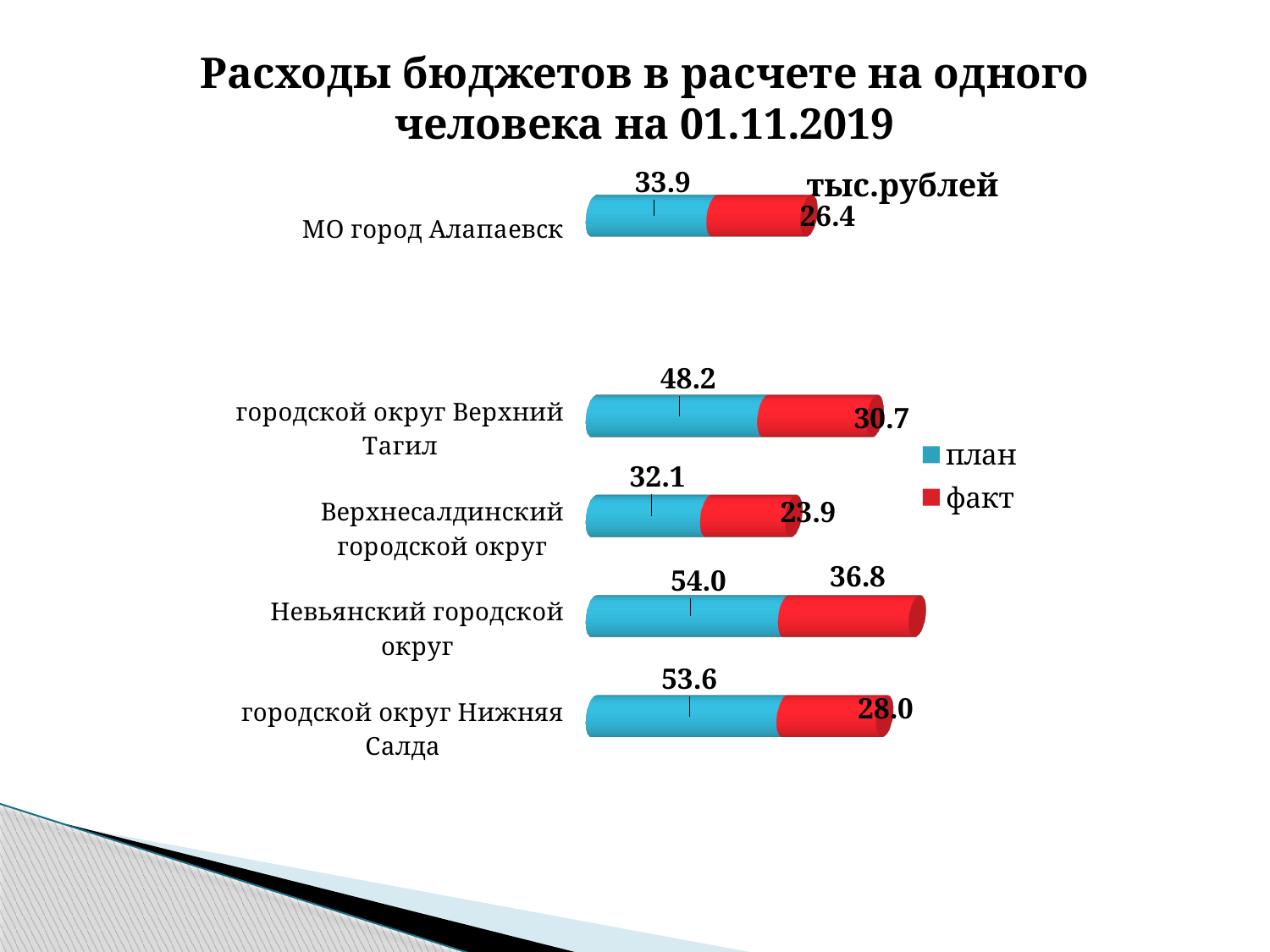
What is the difference between the план and факт values for Невьянский городской округ? 17.2 Which colour represents the факт series in the legend? Red Which is larger: the факт value for городской округ Верхний Тагил or the факт value for городской округ Нижняя Салда? городской округ Верхний Тагил What kind of chart is shown on the slide? Stacked bar chart What is the total of the stacked bar for МО город Алапаевск? 60.3 Which category has the lowest факт value? Верхнесалдинский городской округ What is the план value for Невьянский городской округ? 54.0 What is the план value for городской округ Верхний Тагил? 48.2 What is the факт value for МО город Алапаевск? 26.4 How many series does the legend list? 2 What is the факт value for городской округ Нижняя Салда? 28.0 Which category has the highest план value? Невьянский городской округ